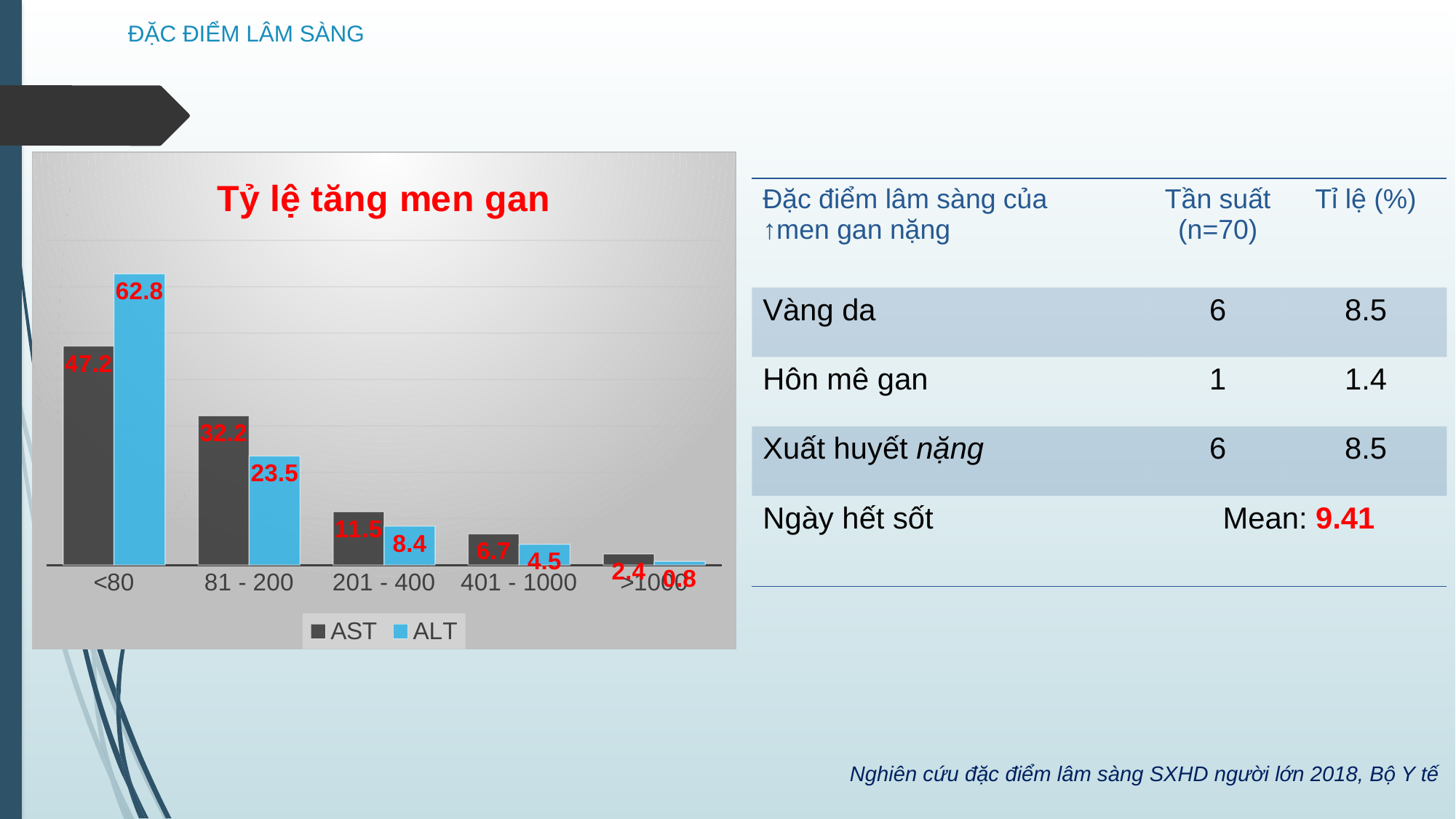
Which category has the highest ALT value? <80 What is the AST value for the <80 category? 47.2 What type of chart is shown on the slide? bar chart For the 401 - 1000 category, which is larger, AST or ALT? AST What is the difference between the ALT and AST values for the <80 category? 15.6 Which category has the lowest AST value? >1000 Do the AST values rise or fall moving from <80 to >1000 along the x axis? fall What is the ALT value for the 81 - 200 category? 23.5 How many categories are shown on the x axis of the chart? 5 What is the ALT value for the 201 - 400 category? 8.4 How many series does the chart legend list? 2 What is the title of the chart? Tỷ lệ tăng men gan